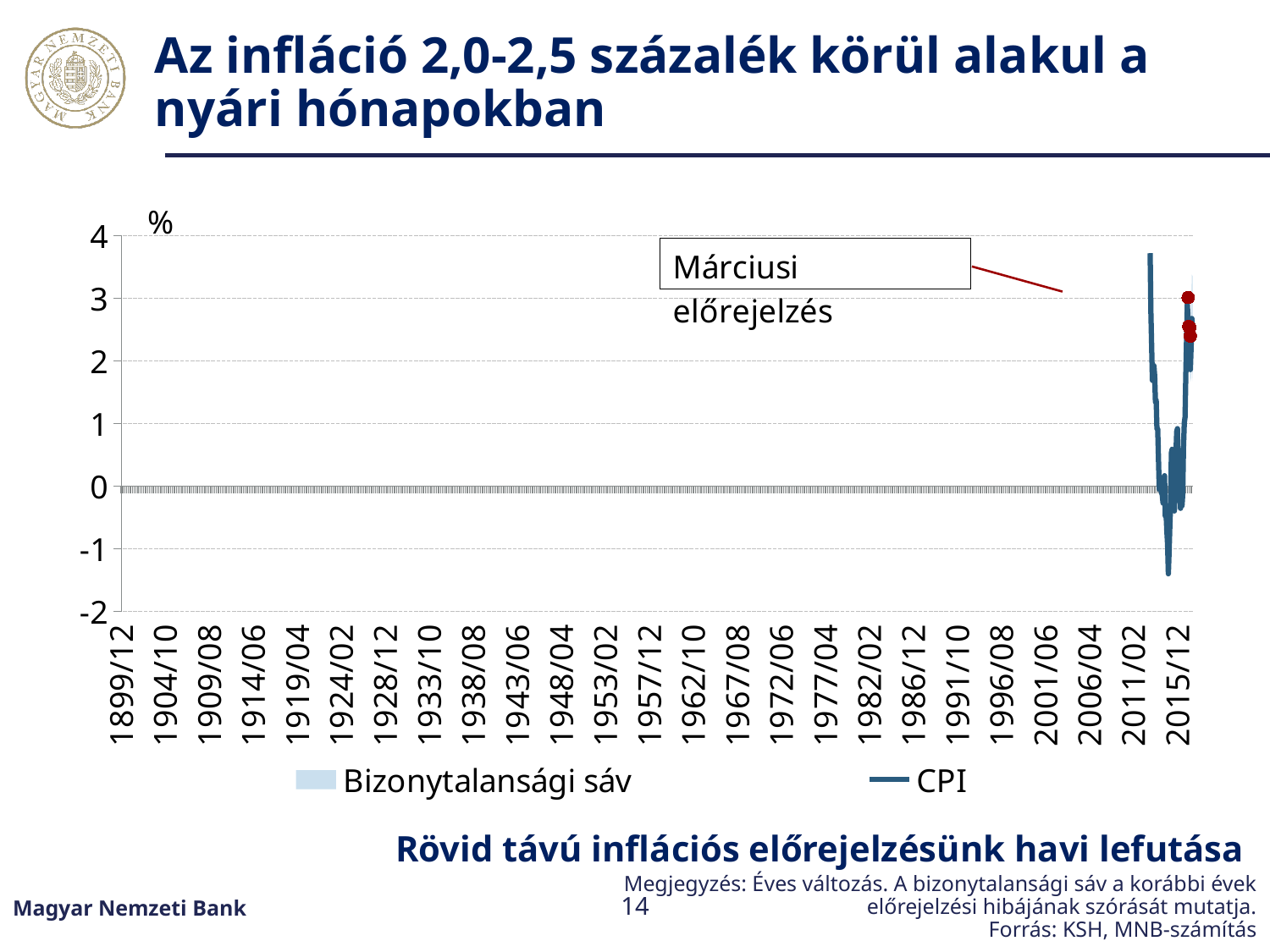
What is the lowest value shown on the vertical axis of the chart? -2 What are the two entries in the chart legend? Bizonytalansági sáv, CPI What is the highest value shown on the vertical axis of the chart? 4 How many series does the chart legend list? 2 Is the highest point of the CPI line greater or less than 3? greater What is the title of the chart on the slide? Rövid távú inflációs előrejelzésünk havi lefutása What is the first label on the horizontal axis of the chart? 1899/12 What is the last label on the horizontal axis of the chart? 2015/12 What unit is indicated at the top of the vertical axis? % What kind of chart is shown on the slide? combination area and line chart